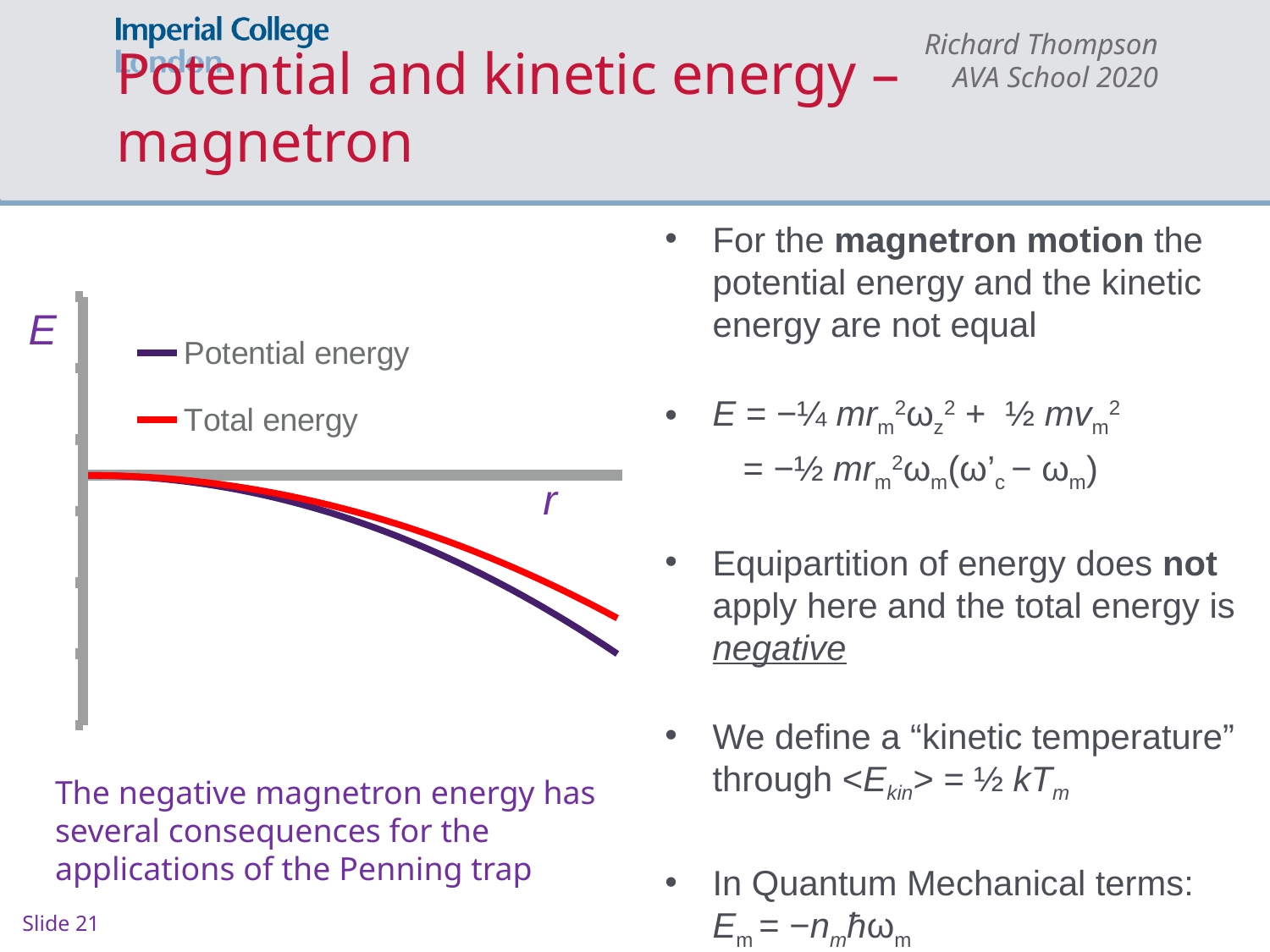
What colour is the Total energy line in the chart? red How many series does the chart's legend list? 2 What label is shown on the horizontal axis of the chart? r At the right-hand end of the chart, which curve is higher: Potential energy or Total energy? Total energy Do the values of the Total energy curve rise or fall as r increases? fall What kind of chart is shown on the slide? line chart At the right-hand end of the chart, which series has the lowest value? Potential energy What are the two series named in the chart's legend? Potential energy and Total energy Do the values of the Potential energy curve rise or fall as r increases? fall